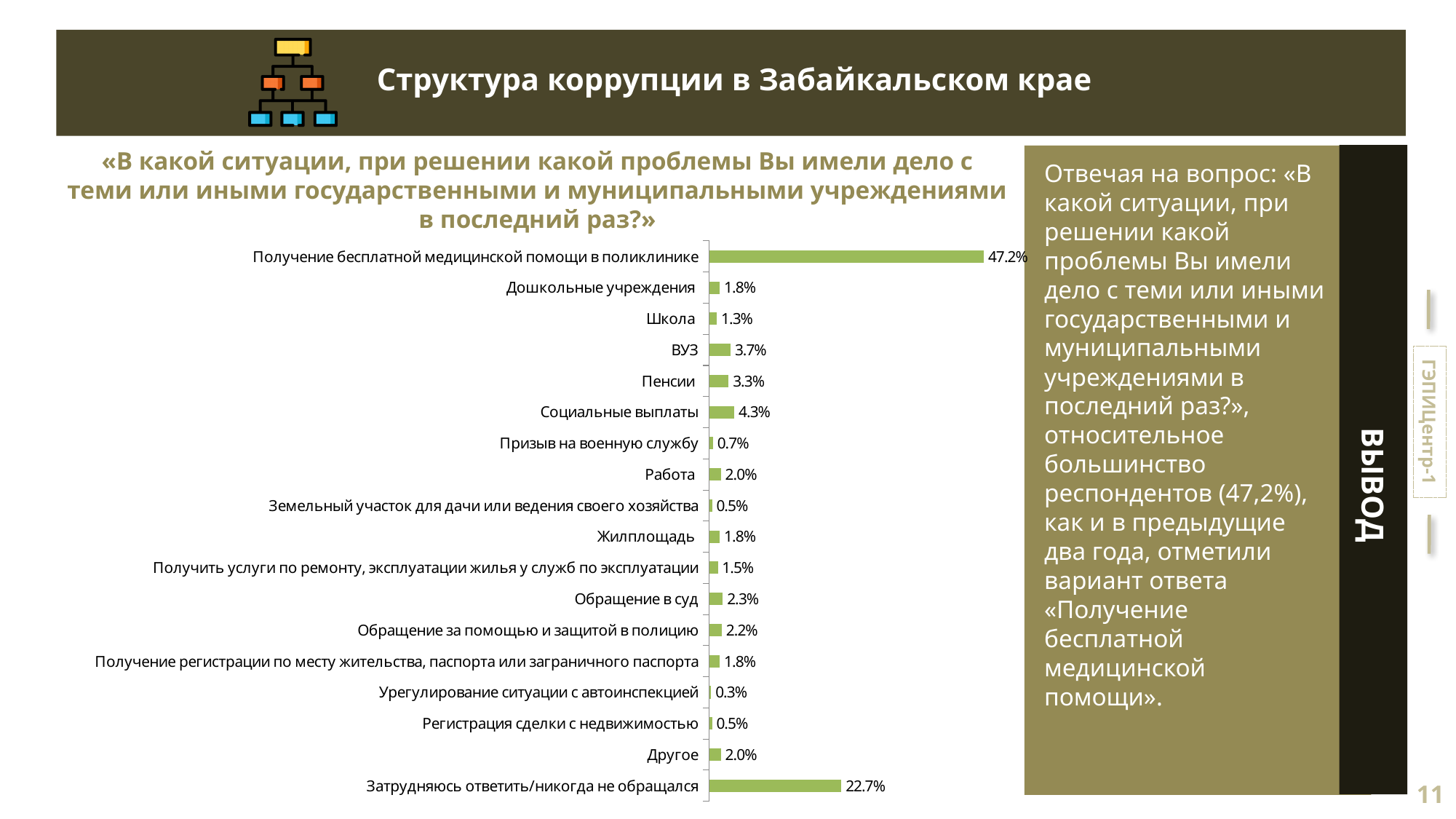
What kind of chart is shown on the slide? Bar chart Which is larger, the value for «ВУЗ» or the value for «Школа»? ВУЗ Which category has the highest value? Получение бесплатной медицинской помощи в поликлинике What is the difference between the values for «ВУЗ» and «Пенсии»? 0.4% Which category has the lowest value? Урегулирование ситуации с автоинспекцией What is the value for «Получение бесплатной медицинской помощи в поликлинике»? 47.2% What is the value for «Затрудняюсь ответить/никогда не обращался»? 22.7% What is the difference between the values for «Получение бесплатной медицинской помощи в поликлинике» and «Затрудняюсь ответить/никогда не обращался»? 24.5% How many categories are shown in the chart? 18 What is the value for «Обращение в суд»? 2.3% What is the value for «Социальные выплаты»? 4.3% What colour are the bars in the chart? Green